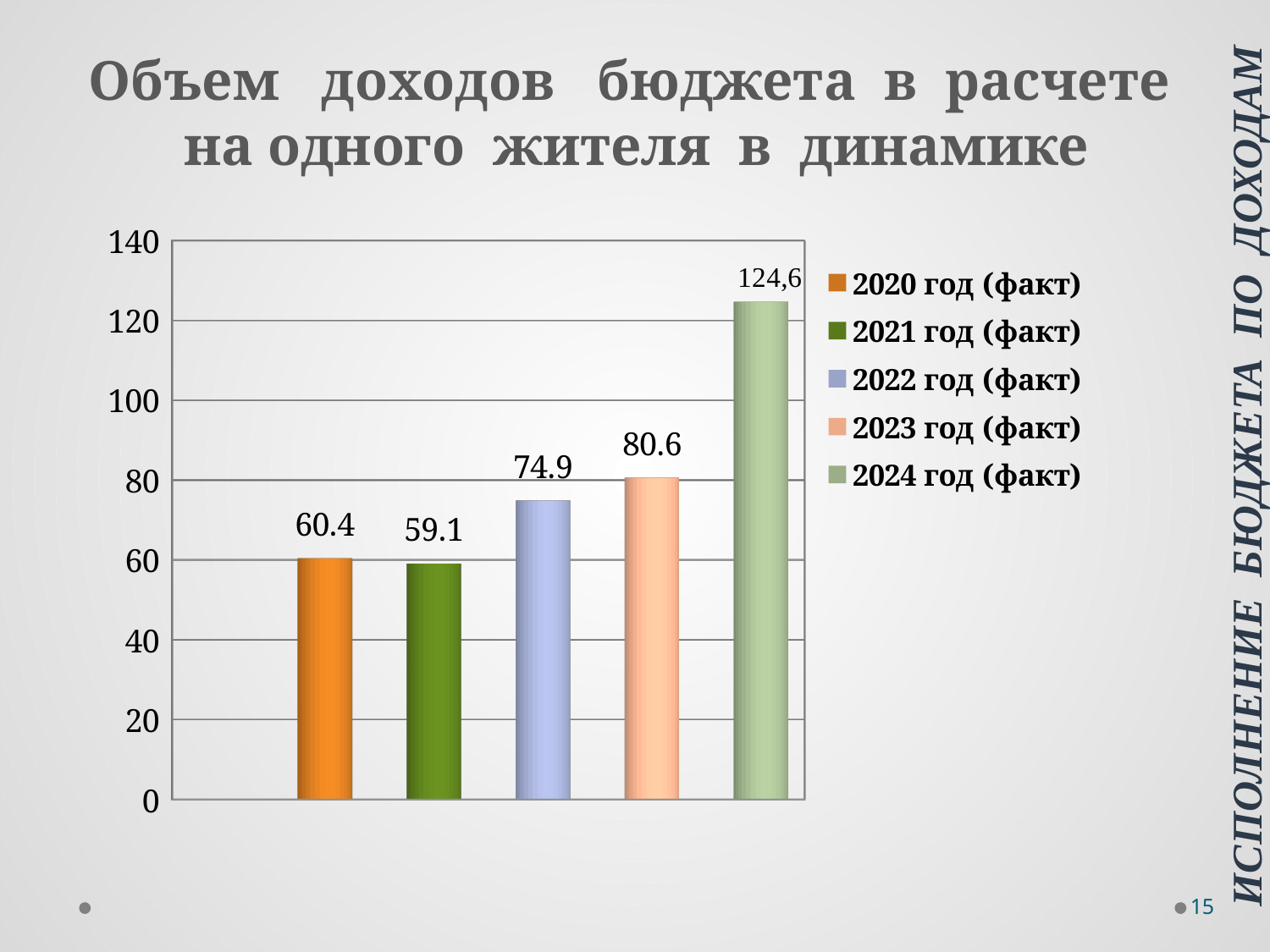
Which year has the highest value? 2024 год (факт) How many series does the legend list? 5 What is the difference between the values for 2023 год (факт) and 2022 год (факт)? 5.7 What is the value for 2020 год (факт)? 60.4 Which is larger, the value for 2020 год (факт) or 2021 год (факт)? 2020 год (факт) What kind of chart is shown on the slide? bar chart What is the value for 2022 год (факт)? 74.9 What is the difference between the values for 2020 год (факт) and 2021 год (факт)? 1.3 How many bars are plotted on the chart? 5 What is the value for 2024 год (факт)? 124,6 Which year has the lowest value? 2021 год (факт) Is the value for 2023 год (факт) greater or less than 100? less